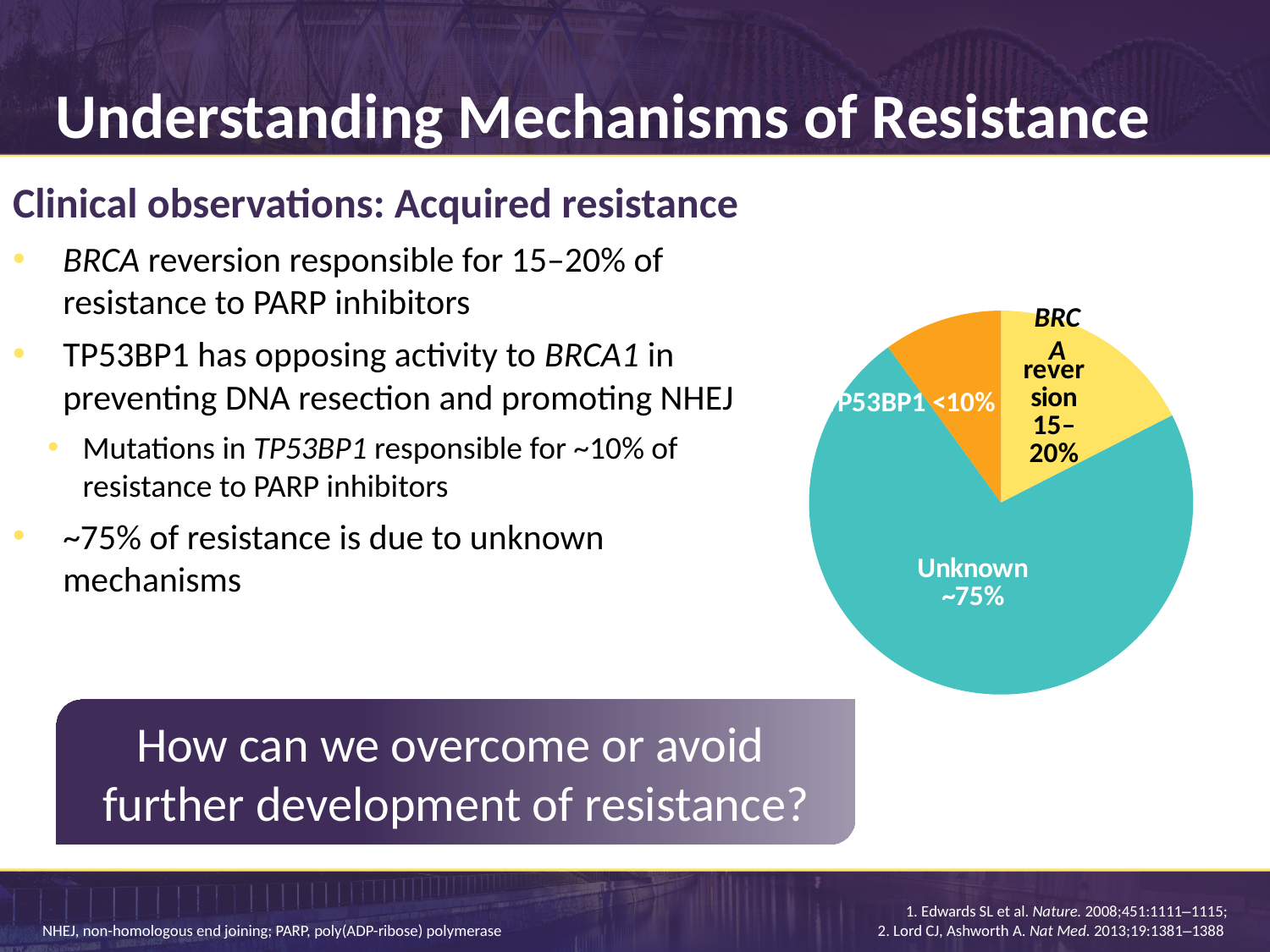
What share does the pie chart label for the BRCA reversion slice? 15–20% Which slice of the pie chart is the smallest? TP53BP1 What share of resistance does the pie chart label for the Unknown slice? ~75% What colour is the Unknown slice in the pie chart? teal What colour is the TP53BP1 slice in the pie chart? orange Is the Unknown slice of the pie chart greater or less than 50% of the pie? greater Which is larger in the pie chart, the BRCA reversion slice or the TP53BP1 slice? BRCA reversion What share does the pie chart label for the TP53BP1 slice? <10% Which slice of the pie chart is the largest? Unknown How many slices does the pie chart have? 3 Which is larger in the pie chart, the Unknown slice or the BRCA reversion slice? Unknown What kind of chart is shown on the slide? pie chart